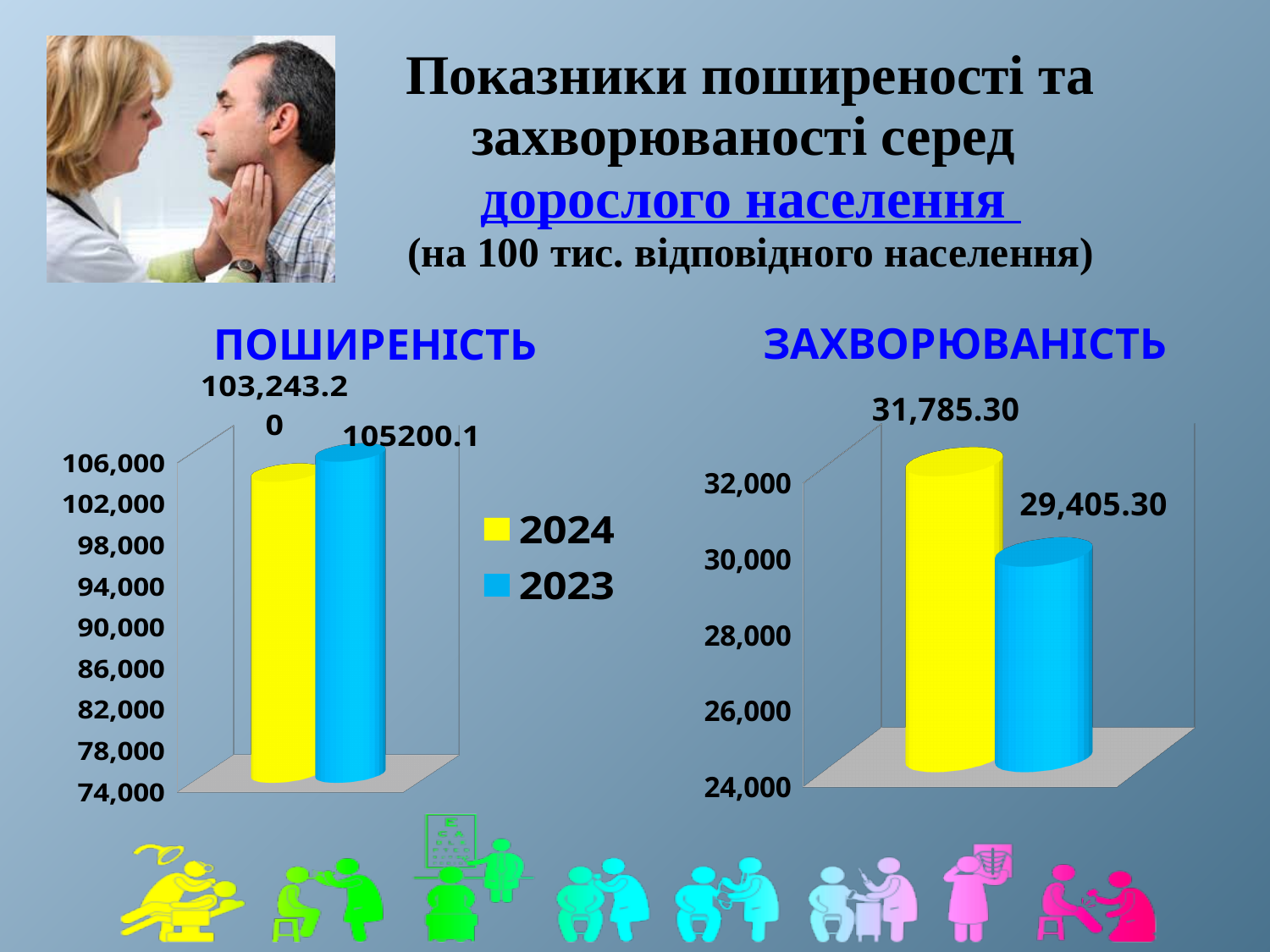
In the ЗАХВОРЮВАНІСТЬ chart, which year has the lower value? 2023 In the ПОШИРЕНІСТЬ chart, is the value for 2024 greater or less than 102,000? greater In the ПОШИРЕНІСТЬ chart, which colour represents 2024 in the legend? Yellow In the ПОШИРЕНІСТЬ chart, what is the value for 2023? 105200.1 In the ЗАХВОРЮВАНІСТЬ chart, what is the difference between the 2024 and 2023 values? 2,380.00 In the ЗАХВОРЮВАНІСТЬ chart, what is the value for 2024? 31,785.30 What kind of chart is the ЗАХВОРЮВАНІСТЬ chart? Bar chart How many series does the legend of the ПОШИРЕНІСТЬ chart list? 2 In the ЗАХВОРЮВАНІСТЬ chart, is the value for 2023 greater or less than 30,000? less In the ПОШИРЕНІСТЬ chart, what is the value for 2024? 103,243.20 In the ПОШИРЕНІСТЬ chart, which year has the higher value? 2023 In the ЗАХВОРЮВАНІСТЬ chart, what is the value for 2023? 29,405.30